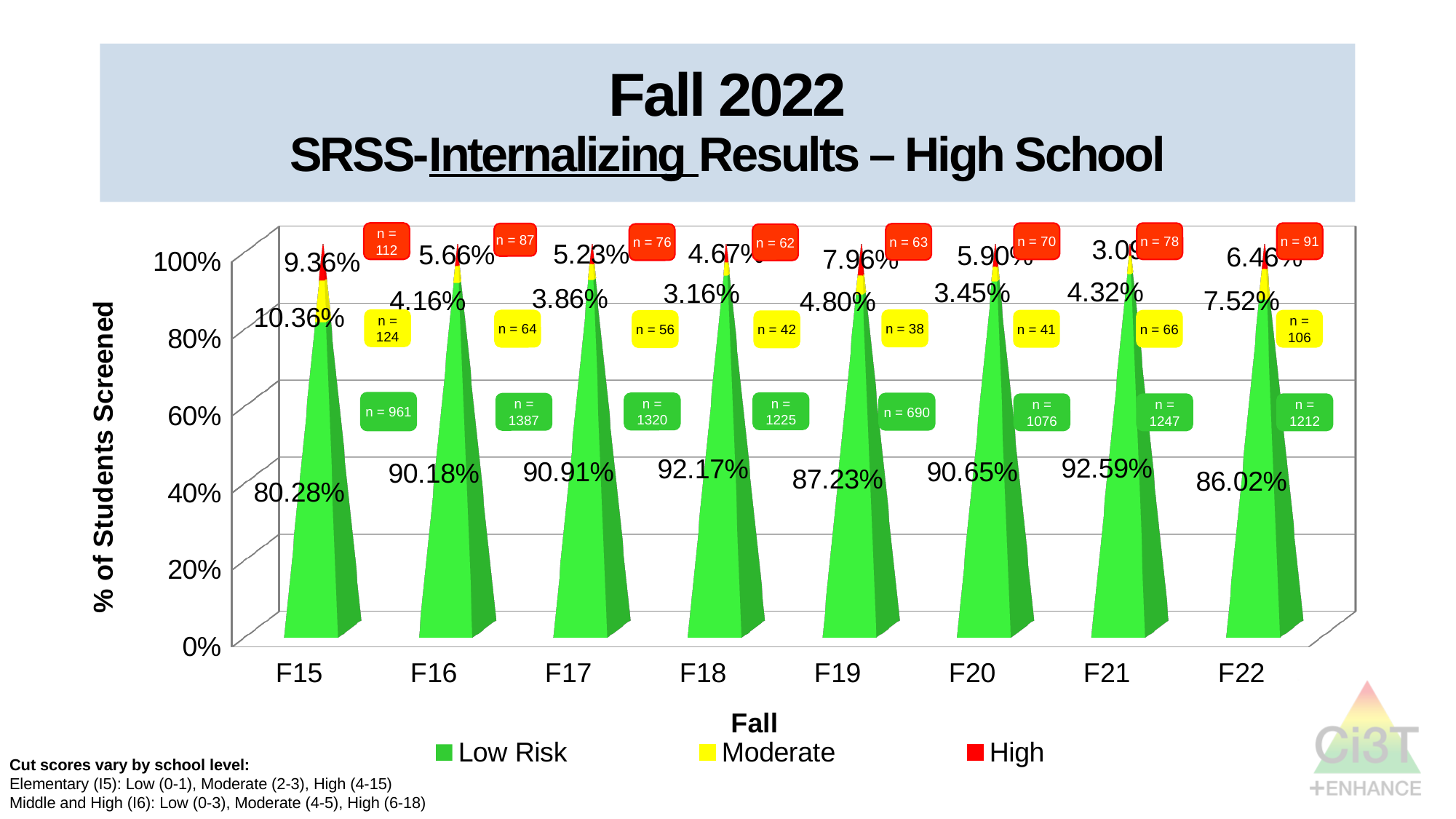
Which fall has the highest Moderate percentage? F15 How many fall periods are shown on the x axis? 8 What is the title of the y axis? % of Students Screened What is the Low Risk percentage for F15? 80.28% What is the n value shown for the Low Risk group in F16? n = 1387 What is the Moderate percentage for F22? 7.52% What is the High percentage for F19? 7.96% Which is larger, the Moderate percentage for F15 or for F22? F15 How many series does the legend list? 3 Which fall has the lowest Low Risk percentage? F15 What is the difference in Low Risk percentage between F16 and F15? 9.90 percentage points Which fall has the highest Low Risk percentage? F21